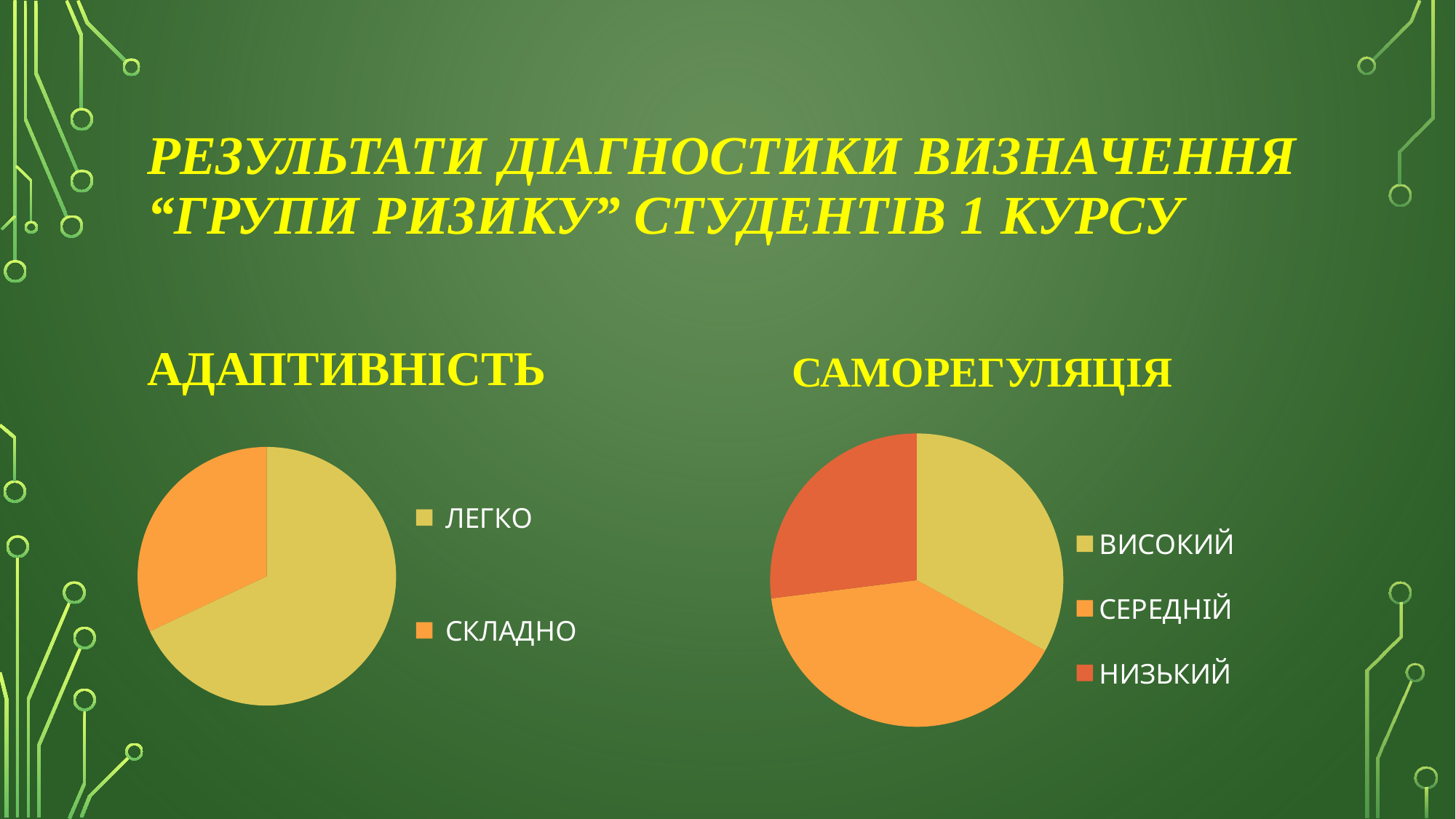
In the АДАПТИВНІСТЬ chart, which category has the largest slice? ЛЕГКО In the САМОРЕГУЛЯЦІЯ chart, what colour is the НИЗЬКИЙ slice? red-orange How many entries does the legend of the АДАПТИВНІСТЬ chart list? 2 How many slices does the САМОРЕГУЛЯЦІЯ pie chart have? 3 In the АДАПТИВНІСТЬ chart, which category has the smallest slice? СКЛАДНО What kind of chart is the АДАПТИВНІСТЬ chart? pie chart In the САМОРЕГУЛЯЦІЯ chart, which slice is larger: СЕРЕДНІЙ or НИЗЬКИЙ? СЕРЕДНІЙ How many slices does the АДАПТИВНІСТЬ pie chart have? 2 How many entries does the legend of the САМОРЕГУЛЯЦІЯ chart list? 3 In the АДАПТИВНІСТЬ chart, which slice is larger: ЛЕГКО or СКЛАДНО? ЛЕГКО In the САМОРЕГУЛЯЦІЯ chart, which category has the largest slice? СЕРЕДНІЙ What kind of chart is the САМОРЕГУЛЯЦІЯ chart? pie chart